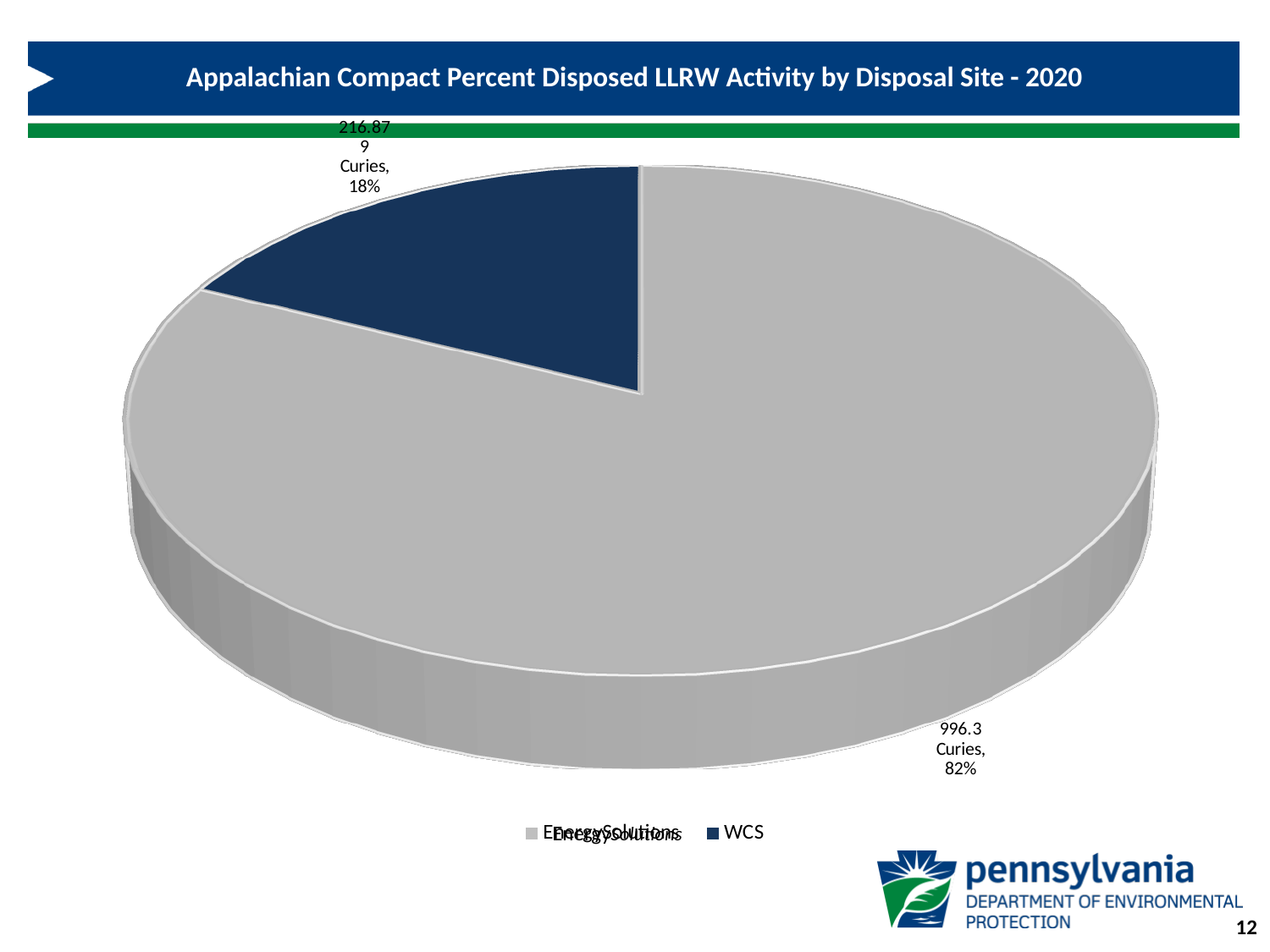
What kind of chart is shown on the slide? pie chart Which disposal site has the largest slice of the pie? EnergySolutions What share of the pie does EnergySolutions account for? 82% Which disposal site has the smallest slice of the pie? WCS How many slices does the pie chart have? 2 What is the title of the chart? Appalachian Compact Percent Disposed LLRW Activity by Disposal Site - 2020 How many entries does the legend list? 2 What colour is the WCS slice? dark blue How many curies are shown for the EnergySolutions slice? 996.3 Curies What share of the pie does WCS account for? 18% Which is larger, the share for EnergySolutions or the share for WCS? EnergySolutions What is the difference in percentage points between the EnergySolutions share and the WCS share? 64 percentage points